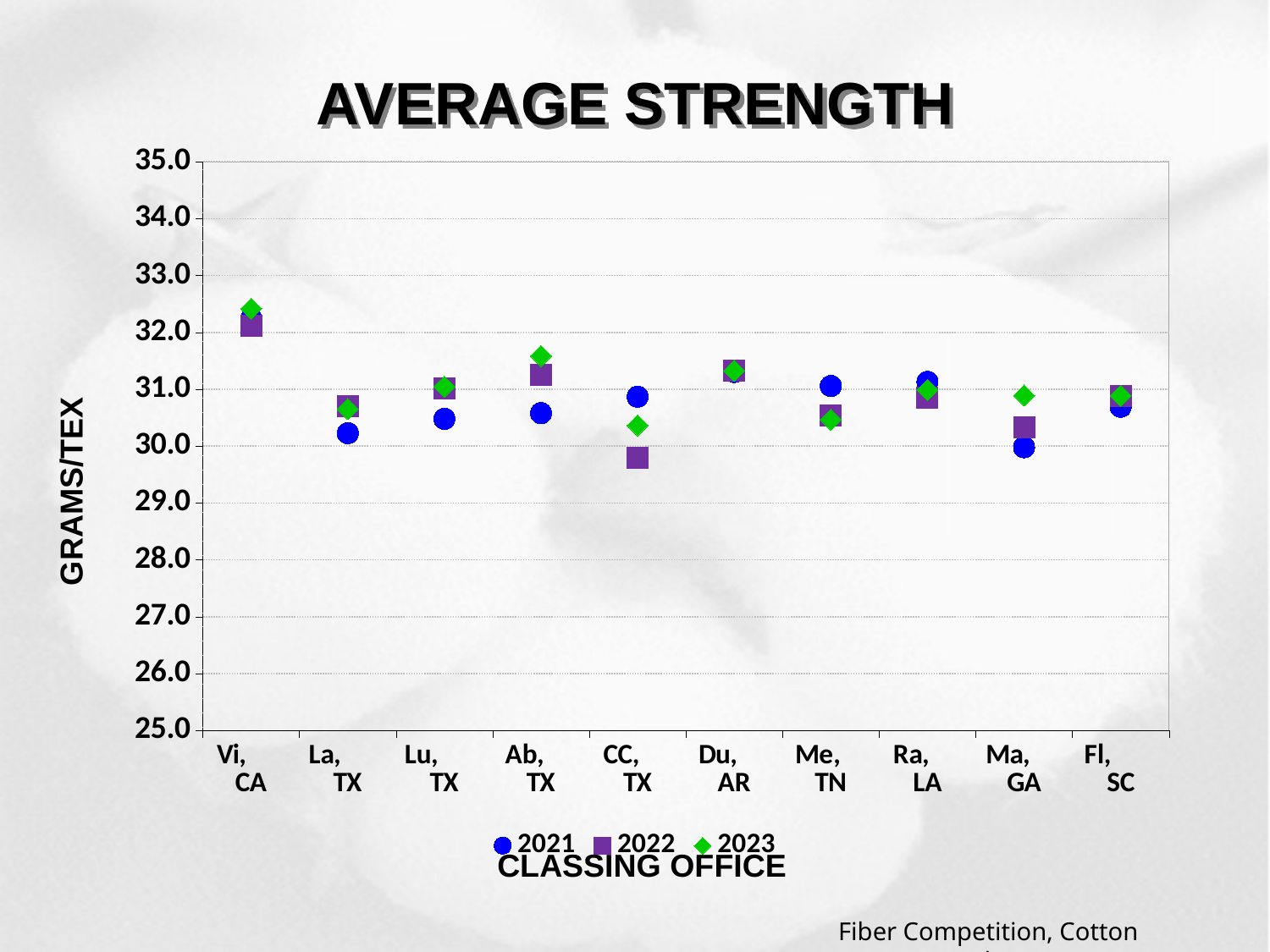
Which classing office has the highest 2021 average strength? Vi, CA What is the title of the y axis? GRAMS/TEX How many classing offices are plotted along the x axis? 10 Is the 2023 value for Vi, CA greater or less than 32.0? greater How many series does the legend list? 3 Is the 2021 value for Ma, GA greater or less than 31.0? less For La, TX, which is larger: the 2021 value or the 2022 value? 2022 Which classing office has the lowest 2022 average strength? CC, TX For Ab, TX, which is larger: the 2021 value or the 2023 value? 2023 Is the 2022 value for CC, TX greater or less than 30.0? less What kind of chart is shown on the slide? scatter chart Which classing office has the highest 2023 average strength? Vi, CA